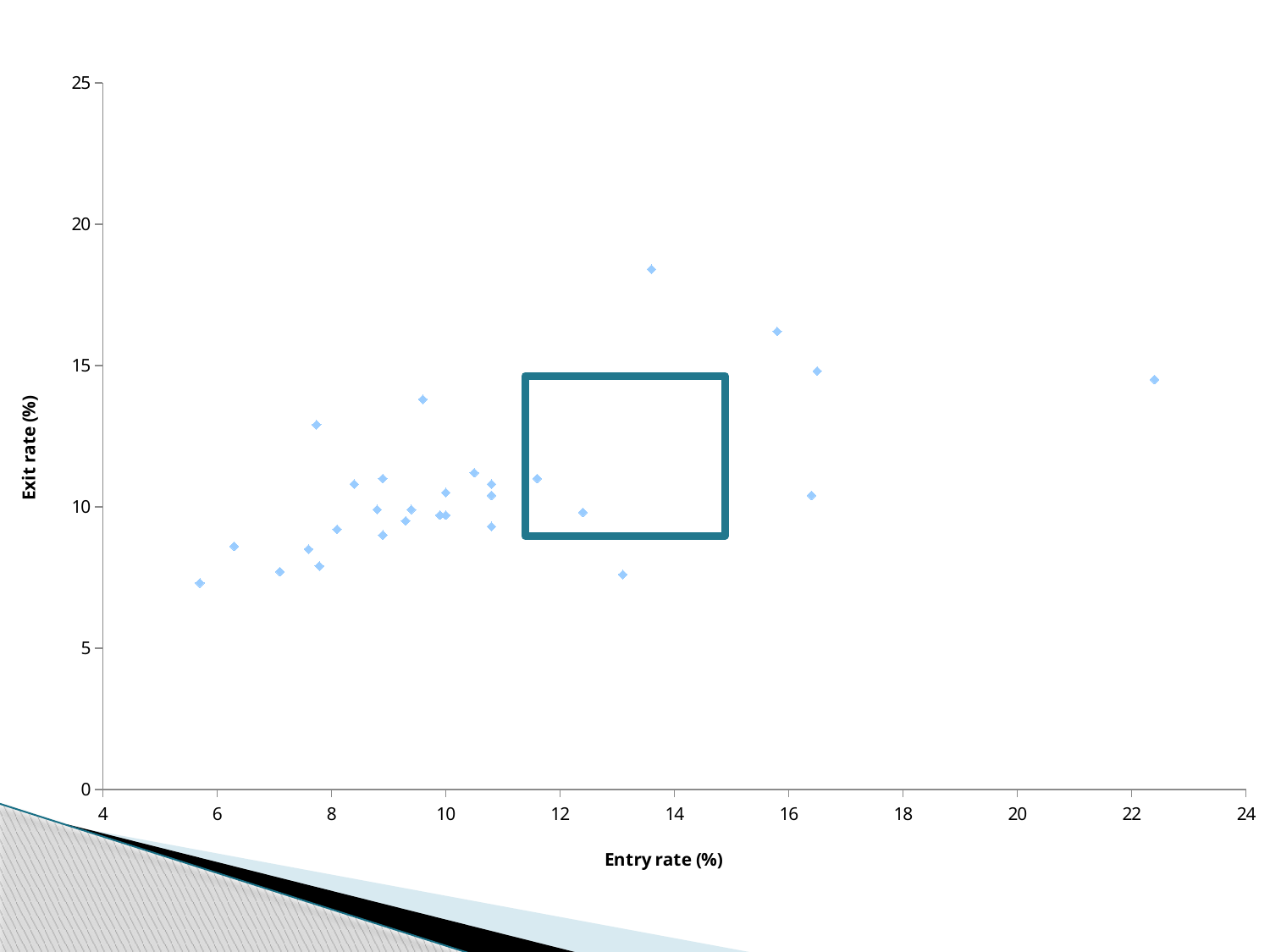
As entry rate increases along the x axis, do exit rates generally rise or fall? rise Is the highest exit rate plotted greater or less than 15? greater Is the entry rate of the point with the highest exit rate greater or less than 12? greater Is the lowest entry rate plotted greater or less than 8? less What kind of chart is shown on the slide? Scatter chart What is the label of the horizontal axis? Entry rate (%) How many data points lie inside the highlighted rectangle? 2 What is the label of the vertical axis? Exit rate (%)